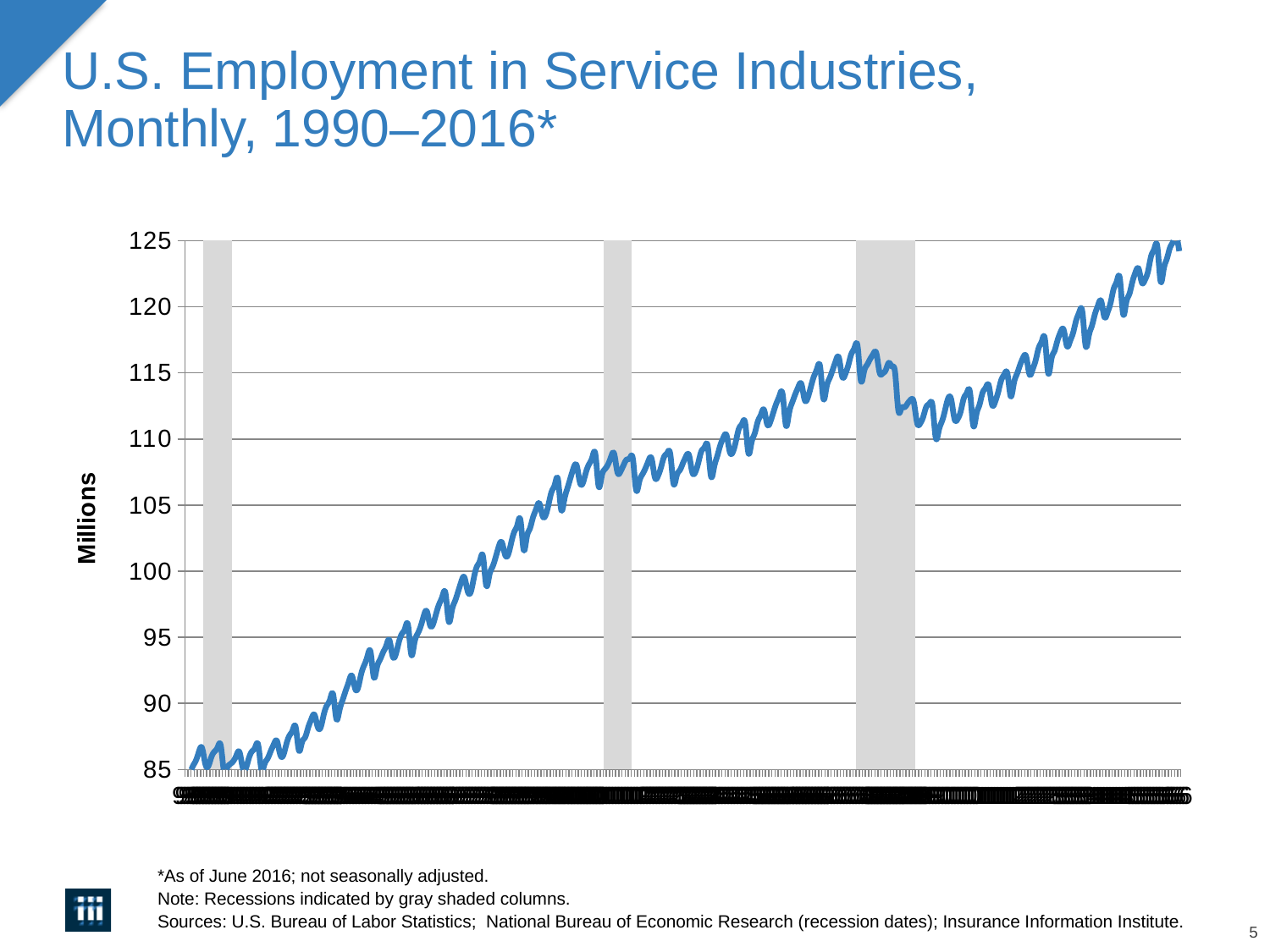
Is the value at the start of the series (1990) greater or less than 90? less What unit is shown on the y axis label? Millions Overall, does U.S. employment in service industries rise or fall from 1990 to 2016? Rise What kind of chart is shown on the slide? Line chart Is the peak reached just before the third gray shaded column greater or less than 115? greater Which is larger, the value at the start of the series or the value at the end of the series? The value at the end of the series How many gray shaded columns (recessions) appear on the chart? 3 Is the value at the end of the series (2016) greater or less than 120? greater